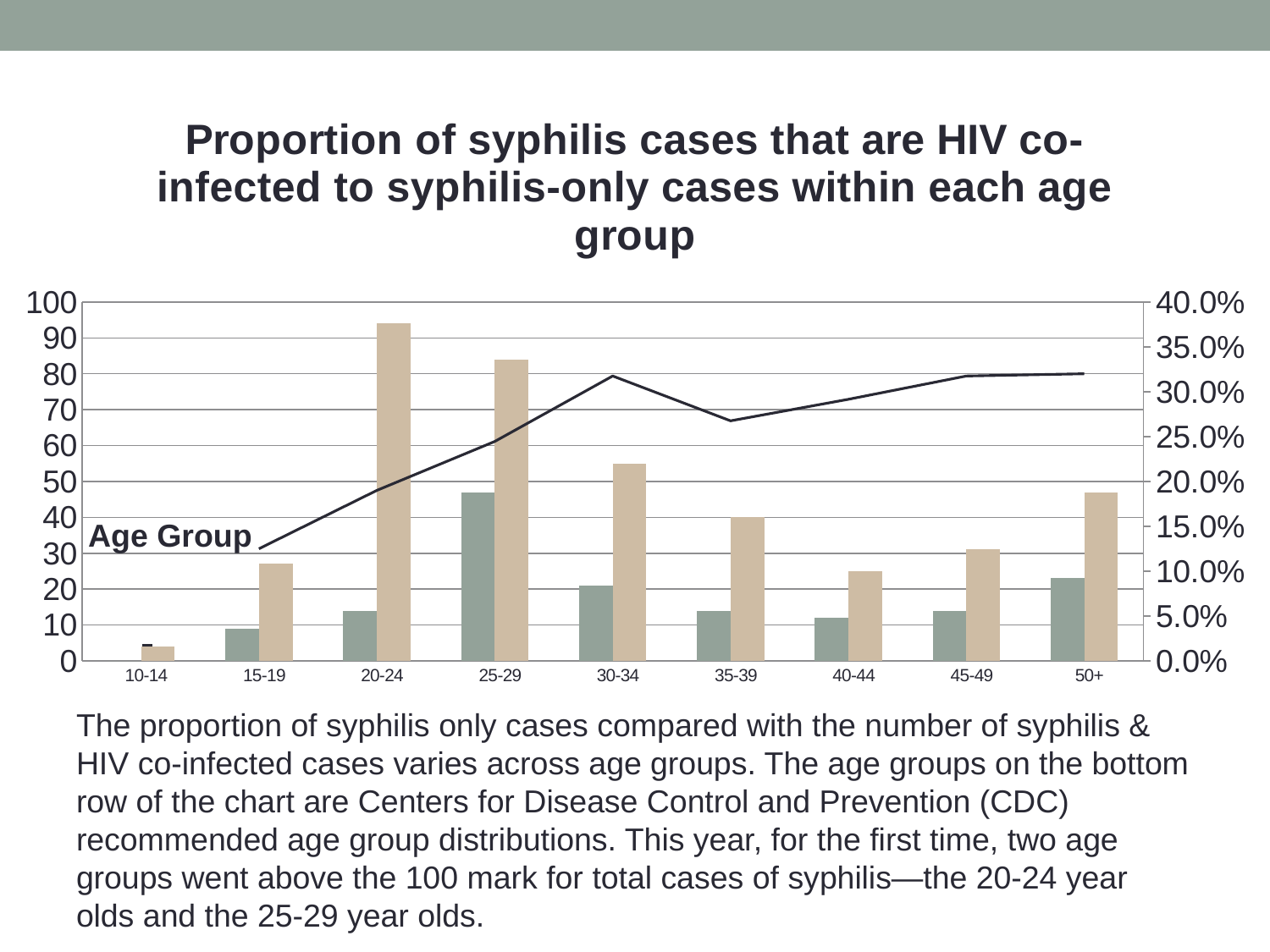
How many age group categories are shown on the x axis? 9 Which age group has the shortest tan bar? 10-14 Is the tan bar for the 15-19 age group greater or less than 30? less What kind of chart is shown on the slide? Bar chart with a line Is the line value for the 35-39 age group greater or less than 25.0%? greater Is the tan bar for the 20-24 age group greater or less than 90? greater Which age group has the tallest tan bar? 20-24 What is the maximum value shown on the right-hand percentage axis? 40.0% Which has the taller tan bar, the 20-24 age group or the 25-29 age group? 20-24 Which age group has the tallest grey-green bar? 25-29